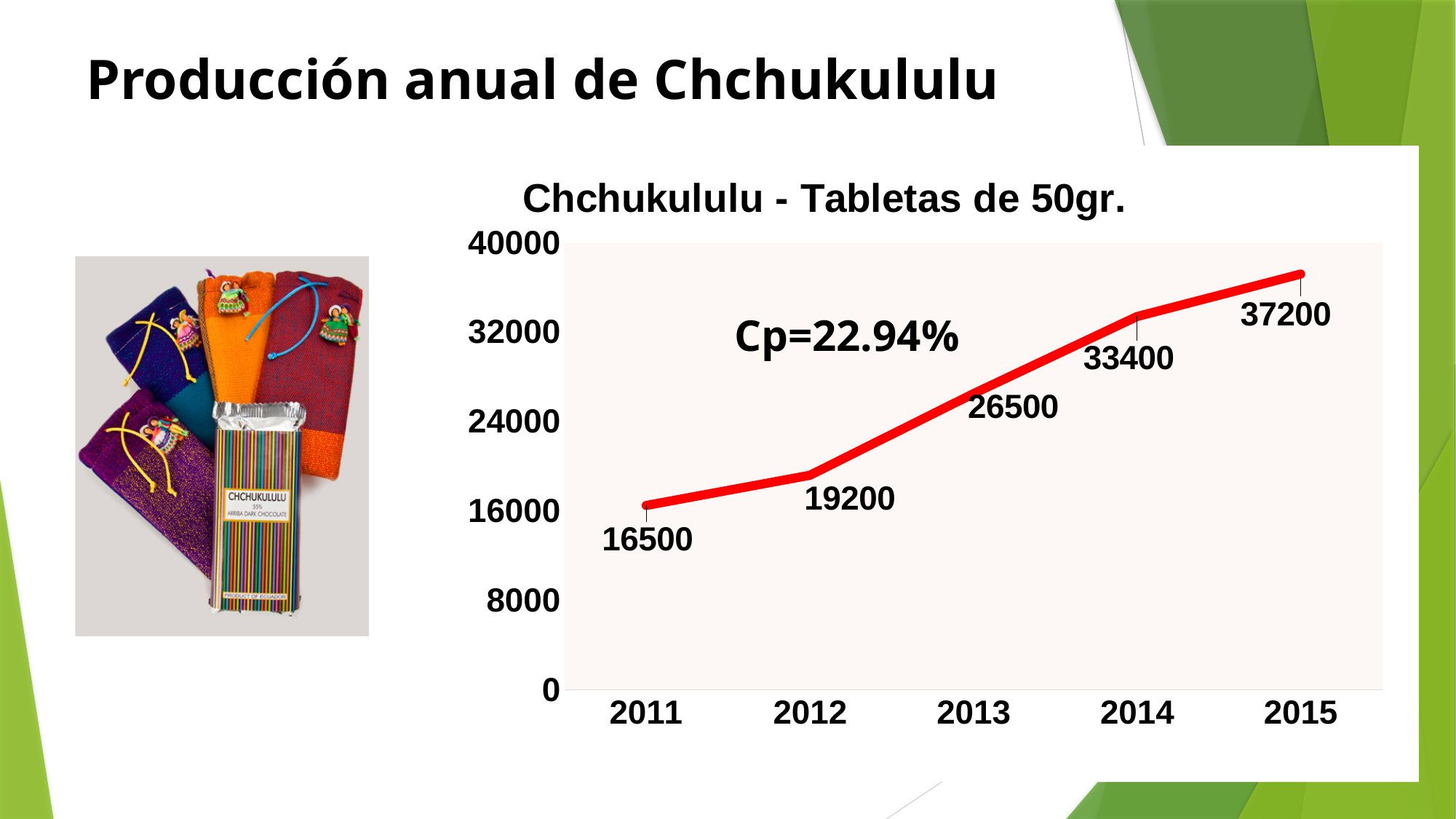
What is the value for 2013? 26500 How many years are plotted on the chart? 5 Is the value for 2013 greater or less than 24000? greater What is the difference between the values for 2015 and 2011? 20700 What is the value for 2011? 16500 What is the value for 2015? 37200 What is the difference between the values for 2014 and 2013? 6900 Which is larger, the value for 2012 or the value for 2014? 2014 What kind of chart is shown? line chart Do the values rise or fall from 2011 to 2015? rise Which year has the highest value? 2015 Which year has the lowest value? 2011